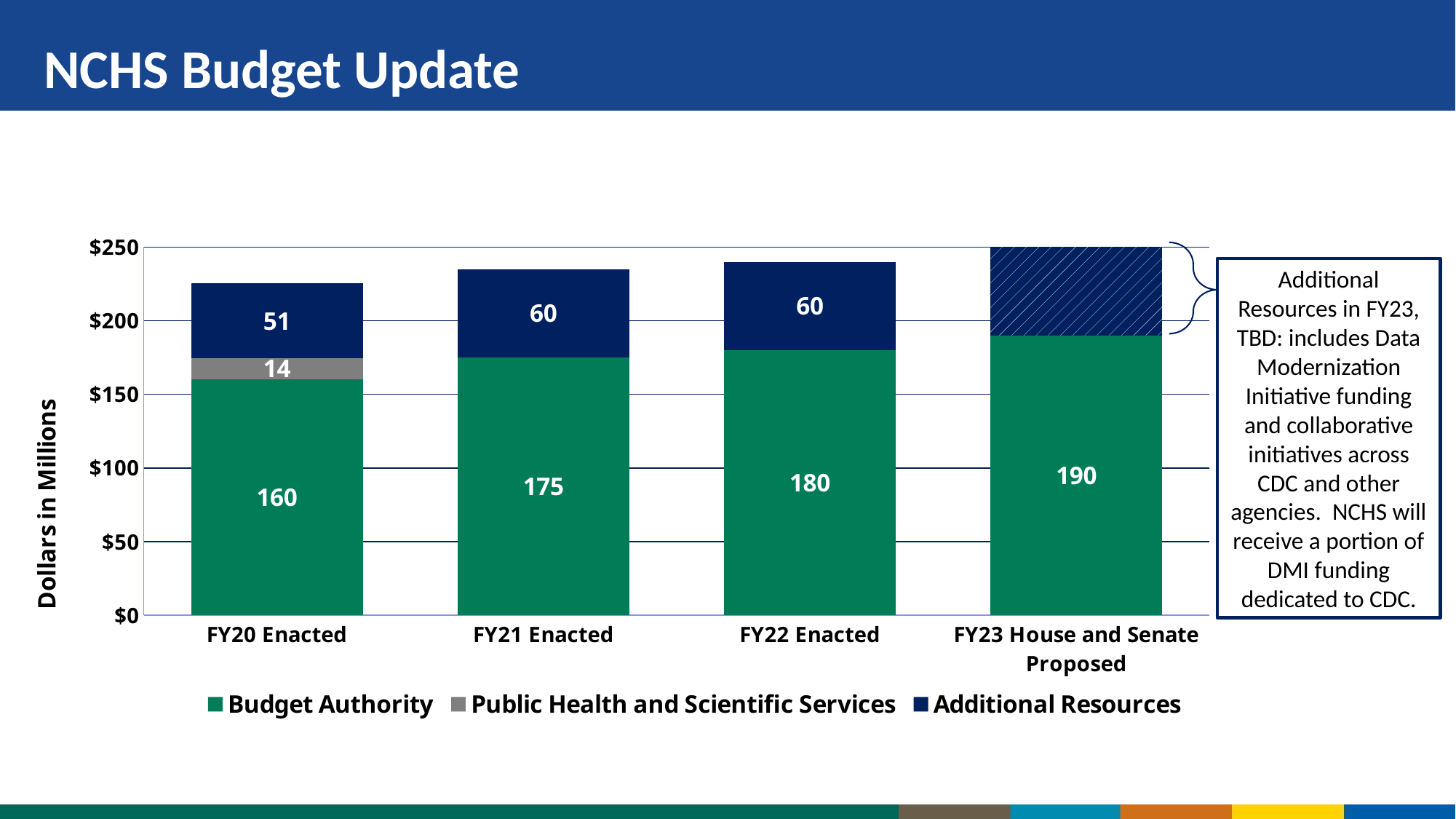
What is the Additional Resources value for FY20 Enacted? 51 What is the Budget Authority value for FY21 Enacted? 175 What is the difference between the Budget Authority values for FY23 House and Senate Proposed and FY20 Enacted? 30 Which category has the highest Budget Authority value? FY23 House and Senate Proposed How many series does the legend list? 3 Which is larger, the Additional Resources value for FY20 Enacted or for FY21 Enacted? FY21 Enacted Is the Budget Authority value for FY22 Enacted greater or less than $150? greater What is the Public Health and Scientific Services value for FY20 Enacted? 14 What kind of chart is shown on the slide? Stacked bar chart How many categories are shown on the x axis? 4 What is the total of the stacked bar for FY20 Enacted? 225 Which category has the lowest Budget Authority value? FY20 Enacted